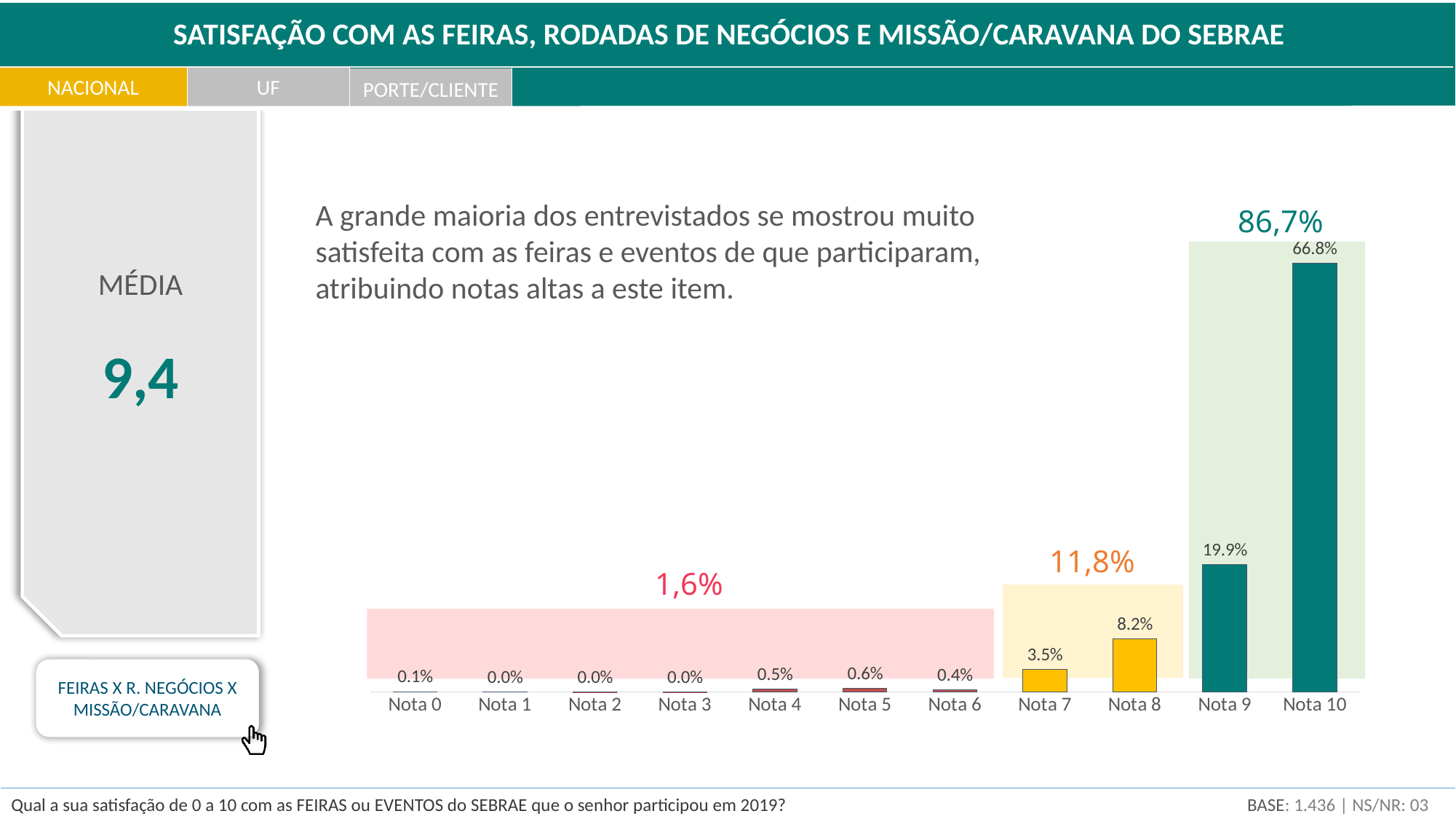
What is the value for Nota 8? 8.2% What kind of chart is shown on the slide? Bar chart What is the difference between the values for Nota 10 and Nota 9? 46.9% What is the value for Nota 10? 66.8% What is the value for Nota 7? 3.5% What is the value for Nota 5? 0.6% Which category has the highest value? Nota 10 What is the value for Nota 9? 19.9% What is the difference between the values for Nota 8 and Nota 7? 4.7% Which is larger, the value for Nota 9 or the value for Nota 8? Nota 9 How many categories are shown on the x axis? 11 What is the combined percentage shown above the group of Nota 9 and Nota 10? 86,7%